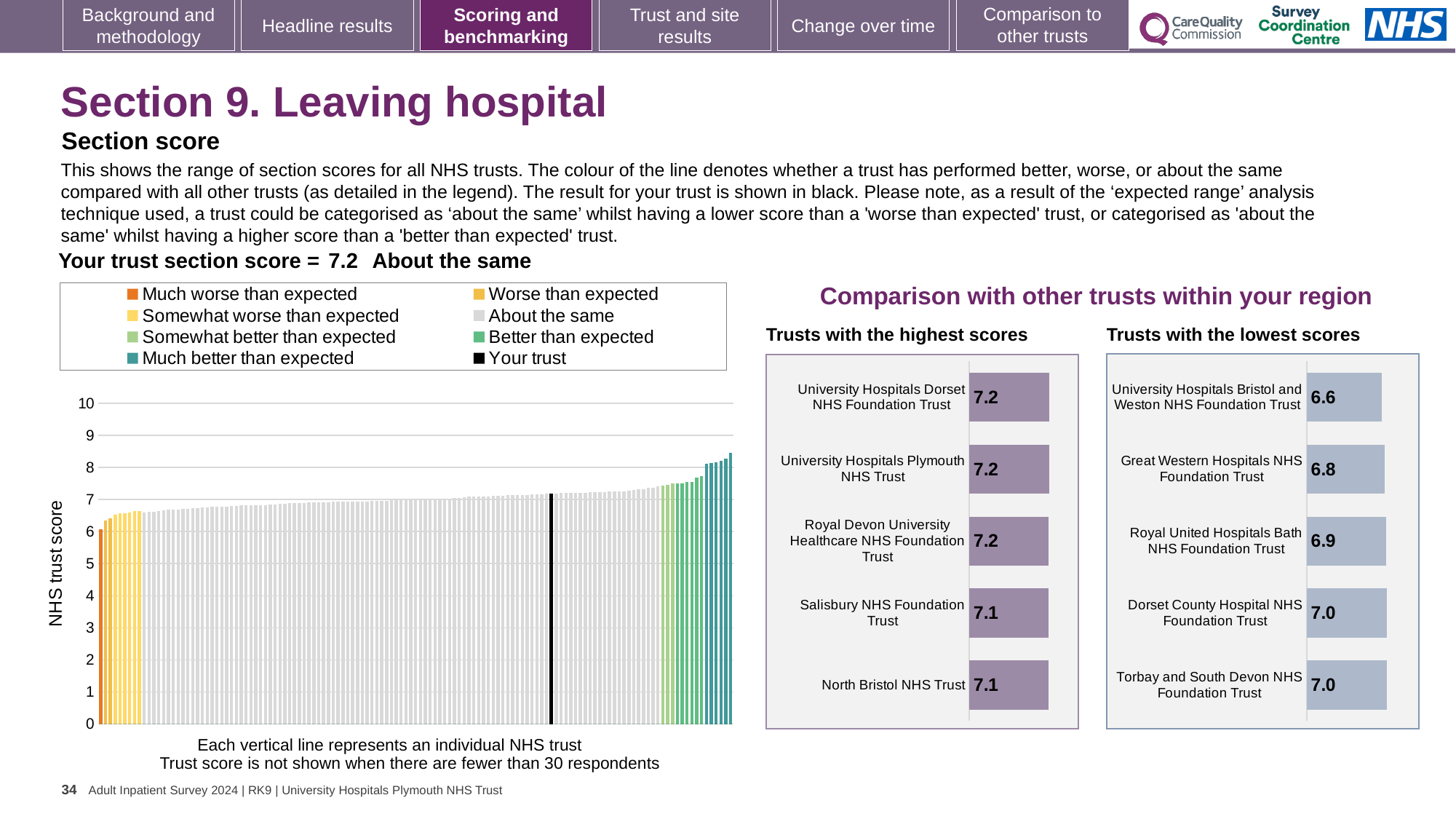
How many trusts are shown in the 'Trusts with the highest scores' chart? 5 In the 'Trusts with the lowest scores' chart, what is the difference between the scores of Royal United Hospitals Bath NHS Foundation Trust and University Hospitals Bristol and Weston NHS Foundation Trust? 0.3 In the 'Trusts with the lowest scores' chart, what is the score for Great Western Hospitals NHS Foundation Trust? 6.8 How many entries does the legend of the NHS trust score chart on the left list? 8 In the 'Trusts with the highest scores' chart, what is the score for Salisbury NHS Foundation Trust? 7.1 In the 'Trusts with the lowest scores' chart, which trust has the lowest score? University Hospitals Bristol and Weston NHS Foundation Trust In the 'Trusts with the highest scores' chart, what is the score for North Bristol NHS Trust? 7.1 In the NHS trust score chart on the left, is the value of the tallest bar greater or less than 8? greater In the 'Trusts with the lowest scores' chart, which has the higher score: Great Western Hospitals NHS Foundation Trust or Dorset County Hospital NHS Foundation Trust? Dorset County Hospital NHS Foundation Trust What kind of chart is the NHS trust score chart on the left of the slide? Bar chart How many trusts are shown in the 'Trusts with the lowest scores' chart? 5 In the NHS trust score chart on the left, do the values rise or fall from left to right? Rise